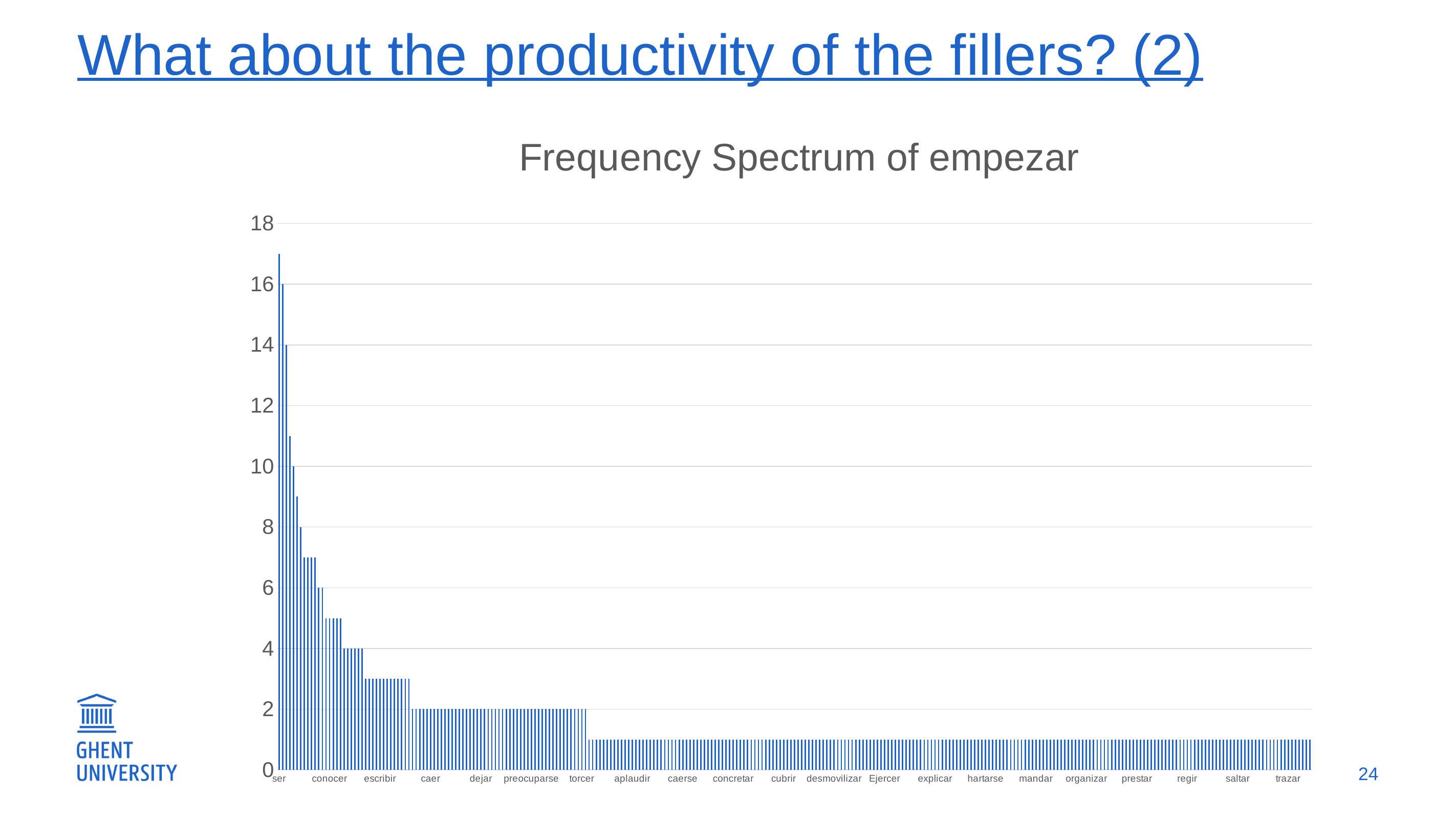
What is the highest tick value shown on the vertical axis? 18 What is the title of the chart? Frequency Spectrum of empezar Is the value for dejar greater or less than 4? less Is the value for saltar greater or less than 2? less What kind of chart is shown on the slide? bar chart Do the values generally rise or fall moving from left to right along the x axis? fall Is the value for trazar greater or less than 2? less Which category has the highest value in the chart? ser Which has the larger value, ser or trazar? ser